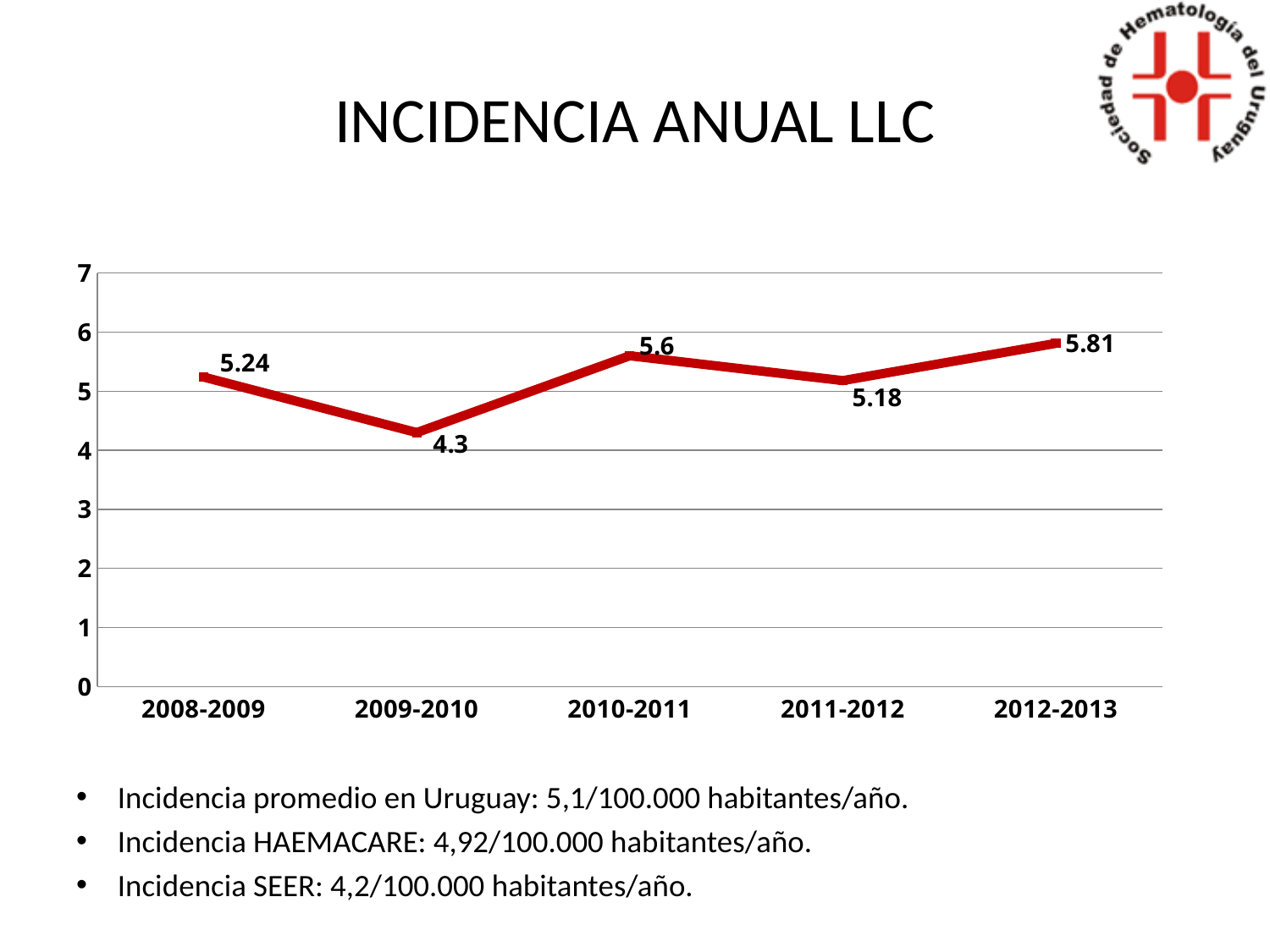
How many periods are plotted on the x axis? 5 What is the value for 2009-2010? 4.3 Which period has the lowest value? 2009-2010 What is the difference between the values for 2012-2013 and 2009-2010? 1.51 What kind of chart is shown on the slide? line chart Which is larger, the value for 2010-2011 or the value for 2011-2012? 2010-2011 Which period has the highest value? 2012-2013 What is the value for 2012-2013? 5.81 What is the value for 2008-2009? 5.24 What is the value for 2010-2011? 5.6 What is the value for 2011-2012? 5.18 Does the value rise or fall from 2011-2012 to 2012-2013? rise